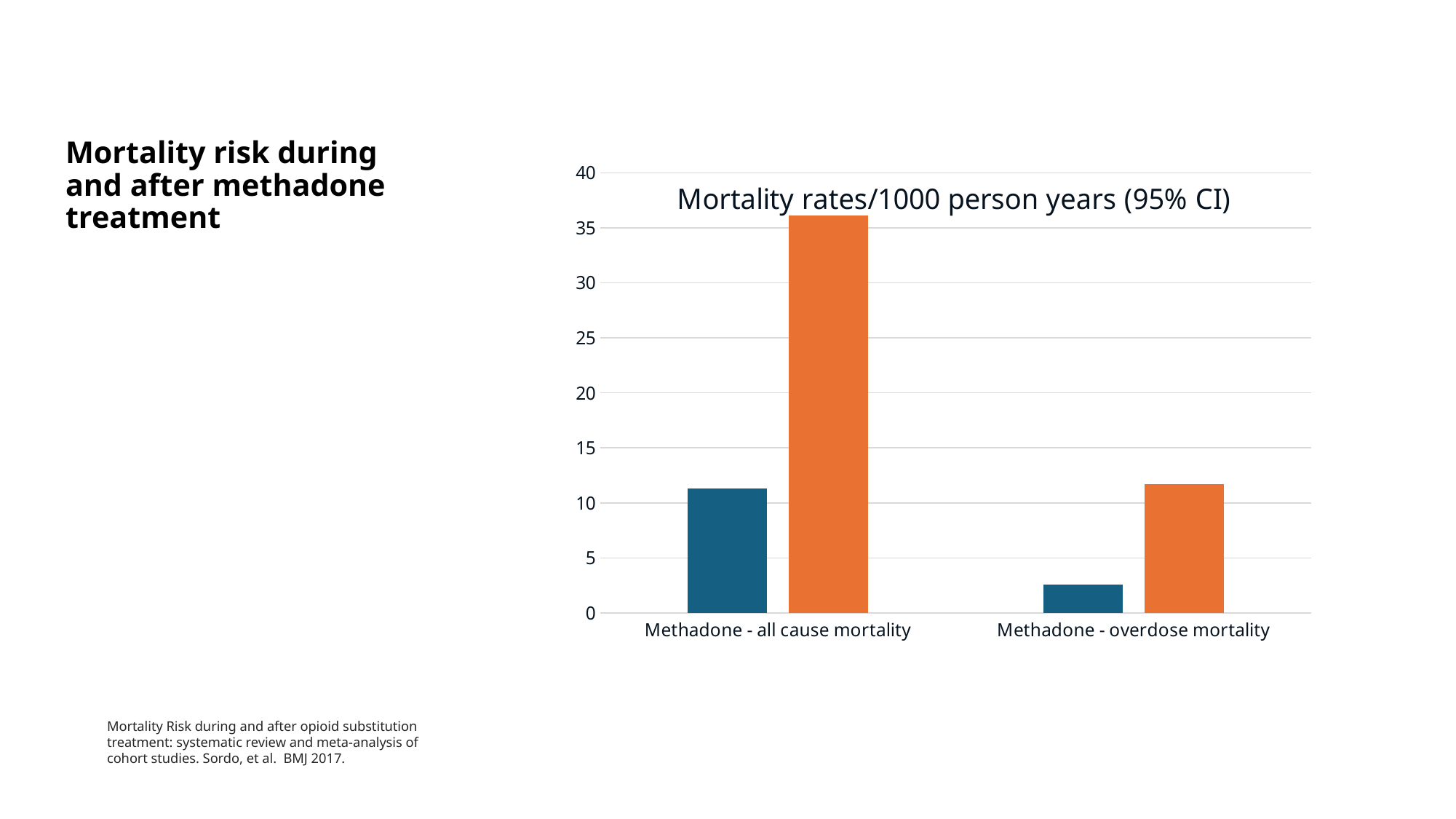
How many bars are plotted in the chart in total? 4 How many categories are shown on the x axis of the chart? 2 What kind of chart is shown on the slide? bar chart Is the blue bar for Methadone - overdose mortality greater or less than 5? less Is the blue bar for Methadone - all cause mortality greater or less than 10? greater What is the highest value shown on the y axis of the chart? 40 Which bar is the shortest in the chart? the blue bar for Methadone - overdose mortality What is the title of the chart? Mortality rates/1000 person years (95% CI) Which bar is the tallest in the chart? the orange bar for Methadone - all cause mortality For Methadone - overdose mortality, which bar is taller, the blue one or the orange one? the orange one Is the orange bar for Methadone - all cause mortality greater or less than 35? greater